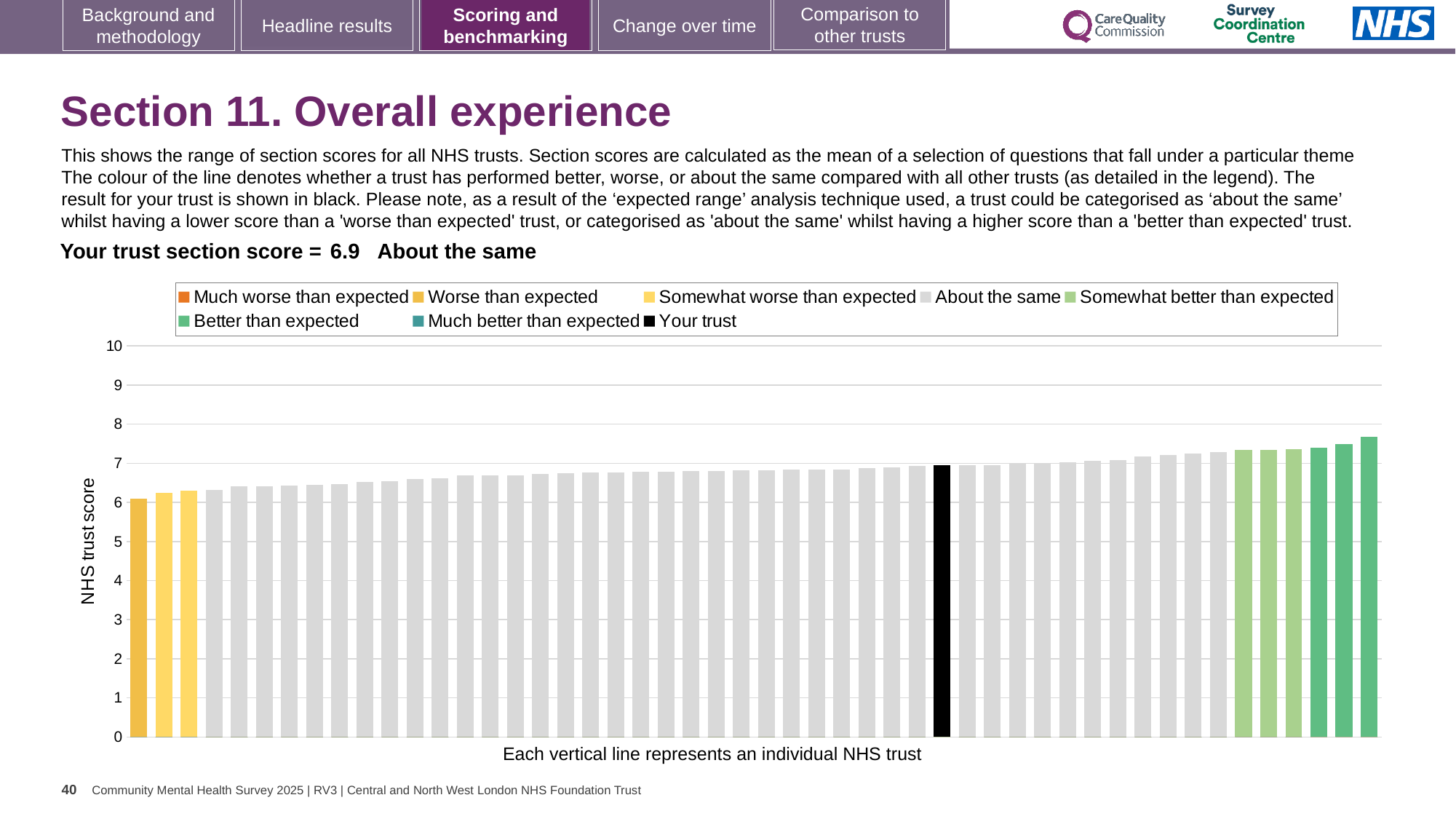
How many bars are shown in yellow shades at the left end of the chart? 3 How is your trust's section score categorised, according to the text above the chart? About the same Is the value for the tallest bar on the right of the chart greater or less than 7? greater Which is larger, the value for your trust (black bar) or the value for the leftmost bar? your trust What is the section score for your trust, as printed on the slide? 6.9 What colour is the bar representing your trust? black What kind of chart is shown on the slide? bar chart Is the value for the leftmost bar greater or less than 7? less Do the bar values rise or fall from left to right along the x axis? rise What is the label on the vertical axis of the chart? NHS trust score How many entries does the chart legend list? 8 Is the value for the black 'Your trust' bar greater or less than 5? greater